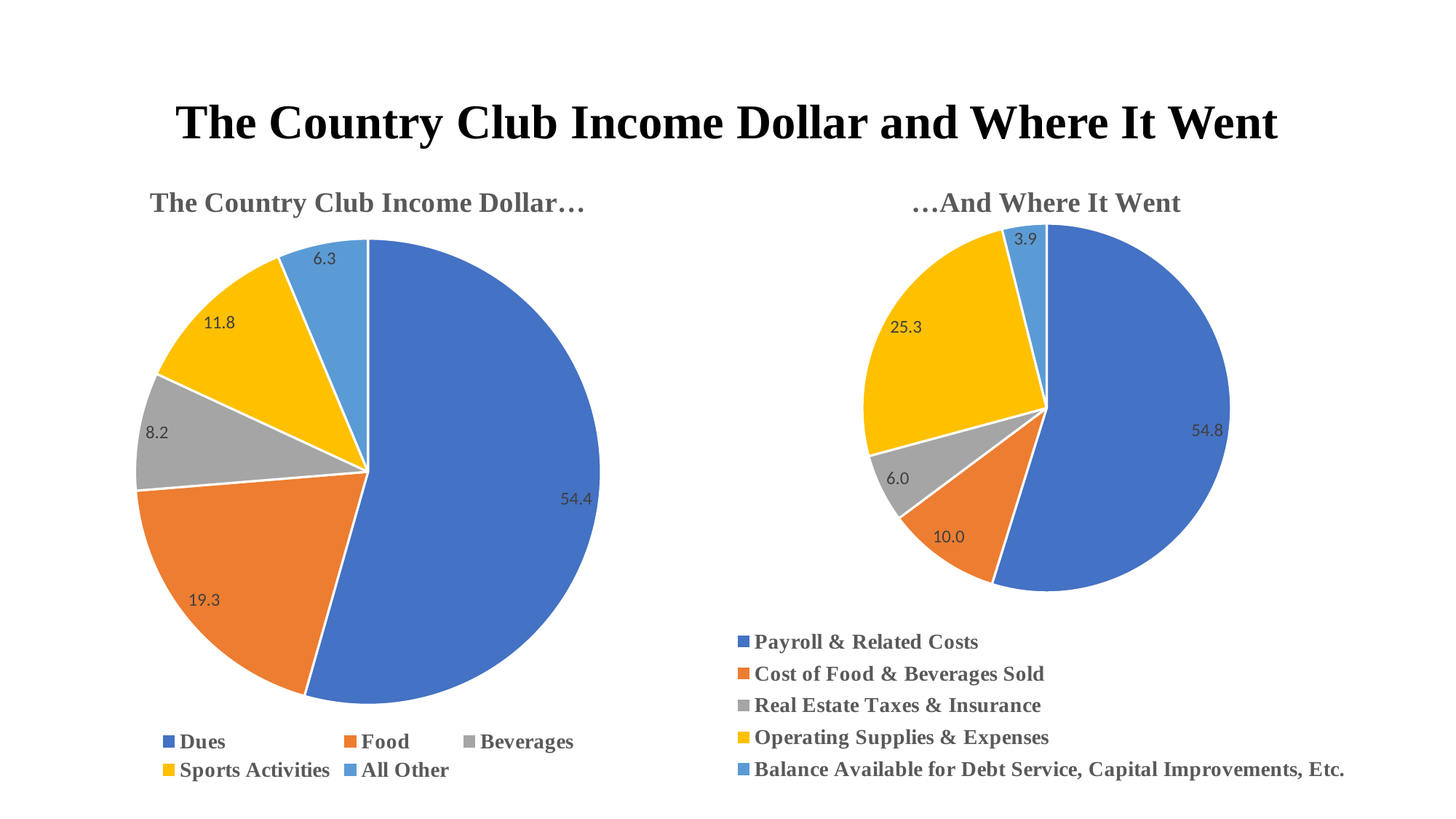
In the chart titled "…And Where It Went", what is the difference between the values for Payroll & Related Costs and Operating Supplies & Expenses? 29.5 In the chart titled "The Country Club Income Dollar…", what is the difference between the values for Sports Activities and Beverages? 3.6 In the chart titled "The Country Club Income Dollar…", how many categories are shown? 5 In the chart titled "…And Where It Went", what is the value for Balance Available for Debt Service, Capital Improvements, Etc.? 3.9 In the chart titled "…And Where It Went", which is larger: Cost of Food & Beverages Sold or Real Estate Taxes & Insurance? Cost of Food & Beverages Sold What kind of chart is the chart titled "…And Where It Went"? Pie chart In the chart titled "…And Where It Went", what is the value for Operating Supplies & Expenses? 25.3 In the chart titled "…And Where It Went", which category has the largest slice? Payroll & Related Costs In the chart titled "The Country Club Income Dollar…", what is the value for Food? 19.3 In the chart titled "The Country Club Income Dollar…", what colour is the Beverages slice? Grey In the chart titled "The Country Club Income Dollar…", what is the value for Dues? 54.4 In the chart titled "The Country Club Income Dollar…", which category has the smallest slice? All Other